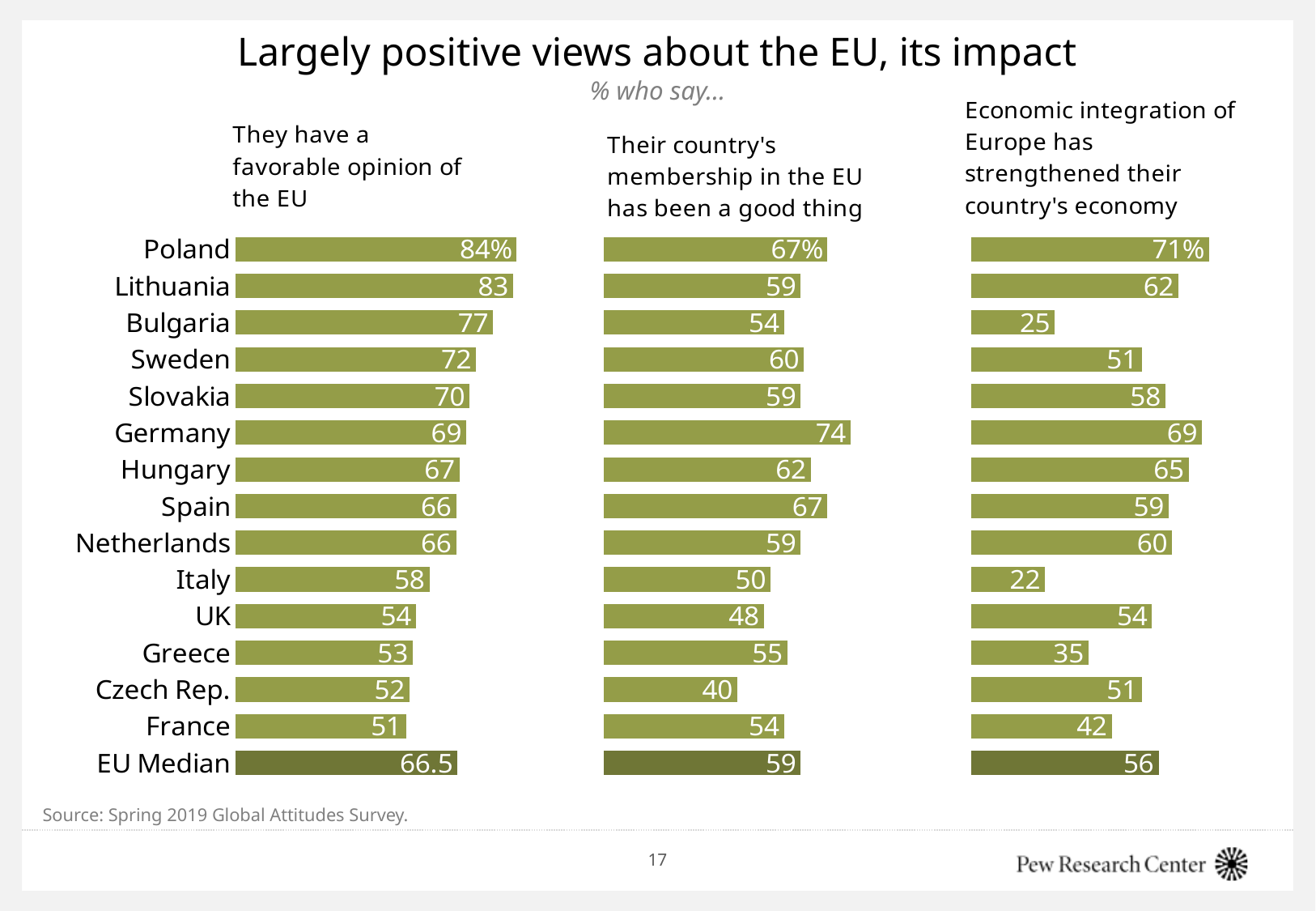
In the chart 'Their country's membership in the EU has been a good thing', which is larger, the value for Czech Rep. or the value for Greece? Greece In the chart 'They have a favorable opinion of the EU', what is the difference between Poland and France? 33 In the chart 'They have a favorable opinion of the EU', what is the value for Poland? 84% What type of chart is used on this slide? Bar chart In the chart 'Economic integration of Europe has strengthened their country's economy', which country has the lowest value? Italy In the chart 'Their country's membership in the EU has been a good thing', which country has the highest value? Germany In the chart 'Their country's membership in the EU has been a good thing', what is the value for Germany? 74 In the chart 'They have a favorable opinion of the EU', what is the EU Median value? 66.5 In the chart 'Economic integration of Europe has strengthened their country's economy', what is the difference between Poland and Bulgaria? 46 How many bars are shown in the chart 'They have a favorable opinion of the EU', including EU Median? 15 In the chart 'They have a favorable opinion of the EU', which country has the lowest value? France In the chart 'Economic integration of Europe has strengthened their country's economy', what is the value for Italy? 22